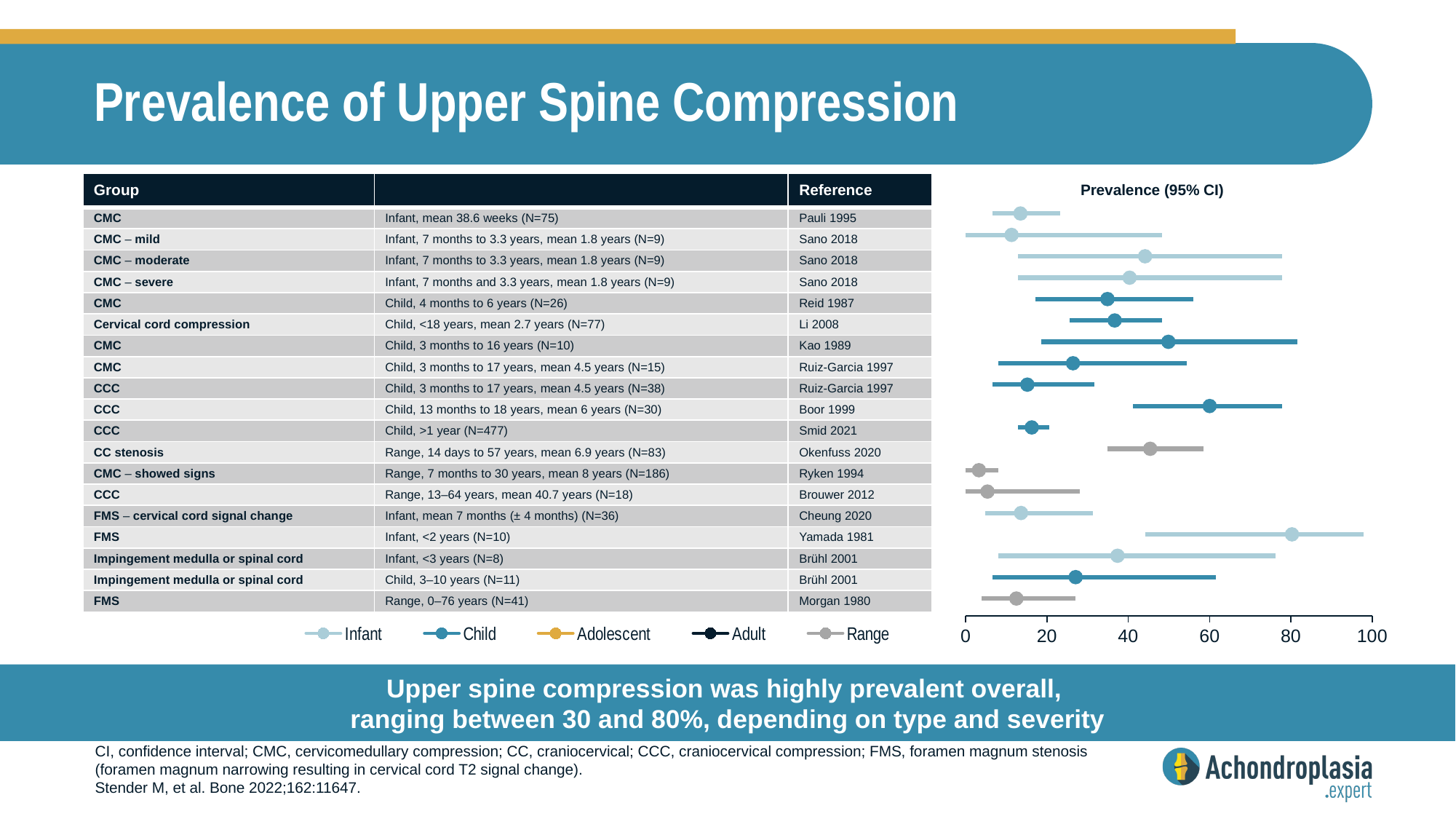
Is the prevalence point for FMS (Yamada 1981) greater or less than 60? greater How many study rows (points) are plotted in the chart? 19 Is the prevalence point for CCC (Boor 1999) greater or less than 40? greater Is the prevalence point for CMC (Kao 1989) greater or less than 40? greater Which has the larger plotted prevalence point: CCC (Boor 1999) or CCC (Smid 2021)? CCC (Boor 1999) Which study row has the highest plotted prevalence point? FMS, Infant, <2 years (N=10), Yamada 1981 What kind of chart is shown on the slide? Forest plot (dot plot with confidence interval bars) Which legend entry is shown in yellow/gold? Adolescent What is the title of the chart on the right of the slide? Prevalence (95% CI) How many series does the chart legend list? 5